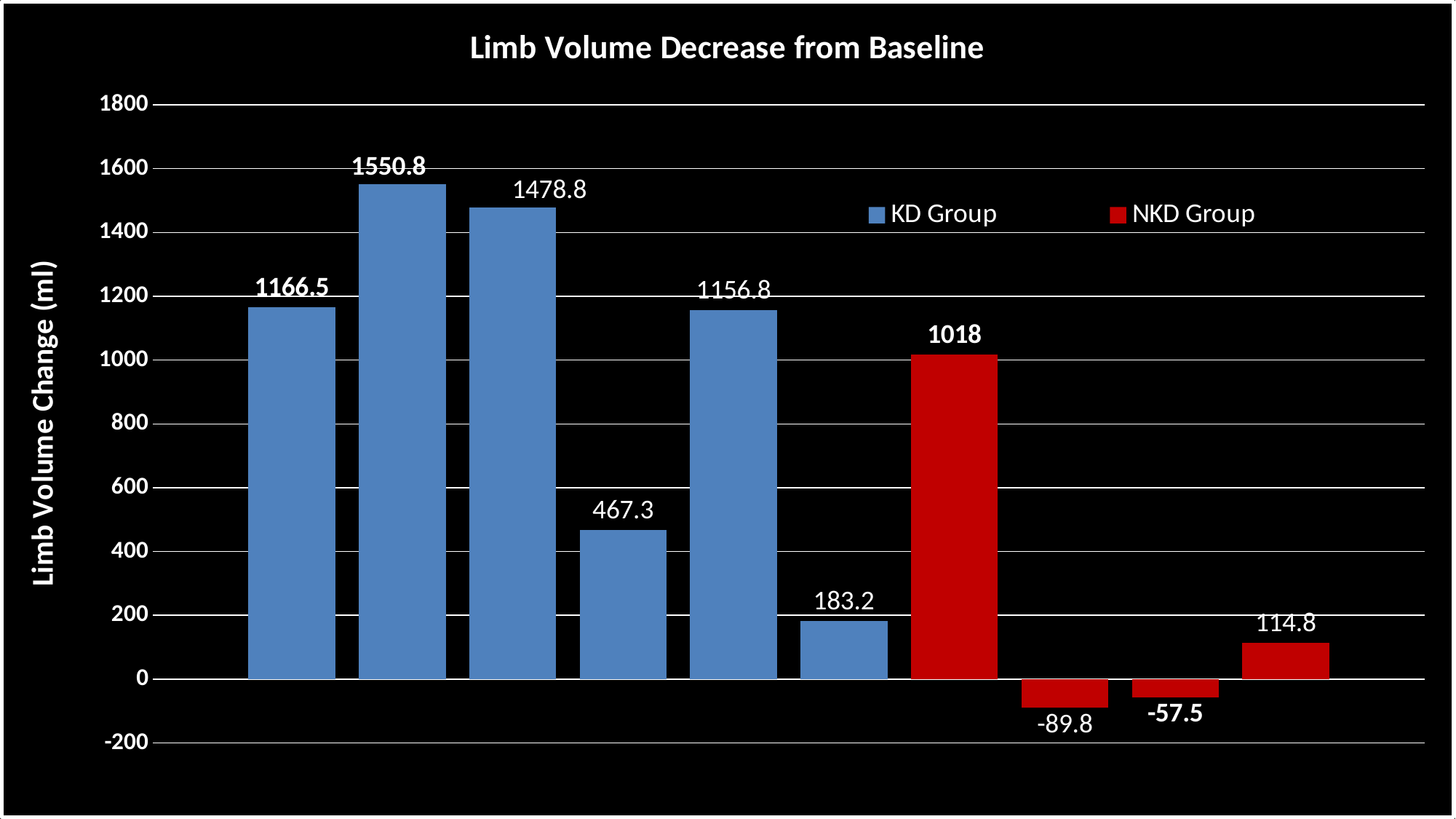
How many bars belong to the KD Group series? 6 What is the label on the vertical axis? Limb Volume Change (ml) Which is larger: the first KD Group bar (1166.5) or the fifth KD Group bar (1156.8)? the first KD Group bar (1166.5) How many bars are plotted in total on the chart? 10 What kind of chart is shown on the slide? bar chart What is the difference between the highest KD Group bar (1550.8) and the highest NKD Group bar (1018)? 532.8 How many series does the legend list? 2 What is the lowest value among the KD Group bars? 183.2 What is the highest value among the KD Group bars? 1550.8 What is the highest value among the NKD Group bars? 1018 What is the title of the chart? Limb Volume Decrease from Baseline What is the lowest value among the NKD Group bars? -89.8